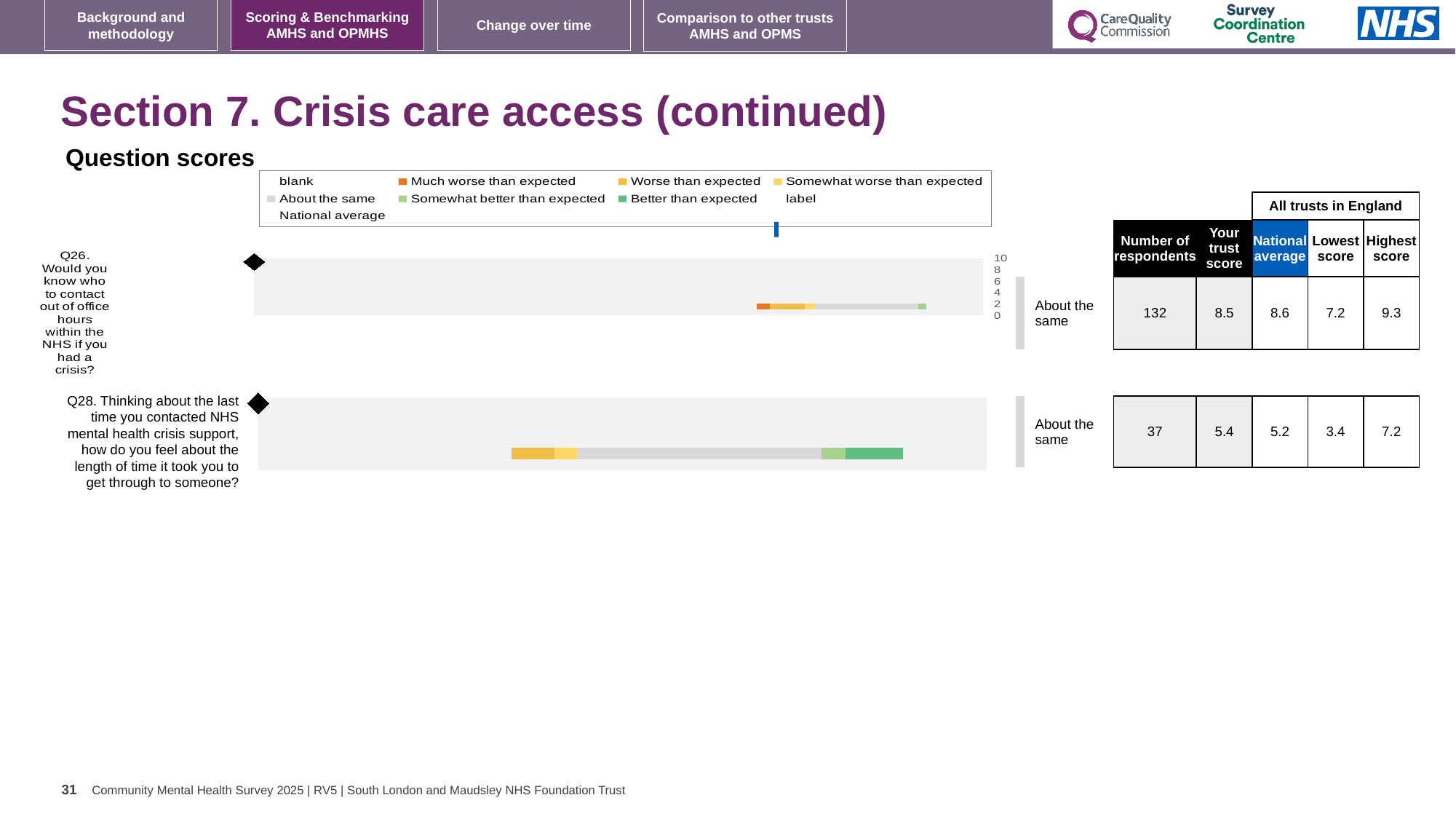
Is your trust score for Q28 greater or less than 6? less For Q28, what is the difference between the highest score and the lowest score among all trusts in England? 3.8 For Q28, which is larger: your trust score or the national average? your trust score What benchmark category label is shown next to the Q26 chart? About the same How many questions are charted on the slide? 2 For Q26, what is the difference between the highest score and the lowest score among all trusts in England? 2.1 What kind of chart is used to show the Q26 and Q28 question scores? bar chart For Q26, what is the national average score? 8.6 For Q26, what is the number of respondents? 132 For Q28, what is the highest score among all trusts in England? 7.2 For Q28, what is your trust score? 5.4 For Q26, what is your trust score? 8.5